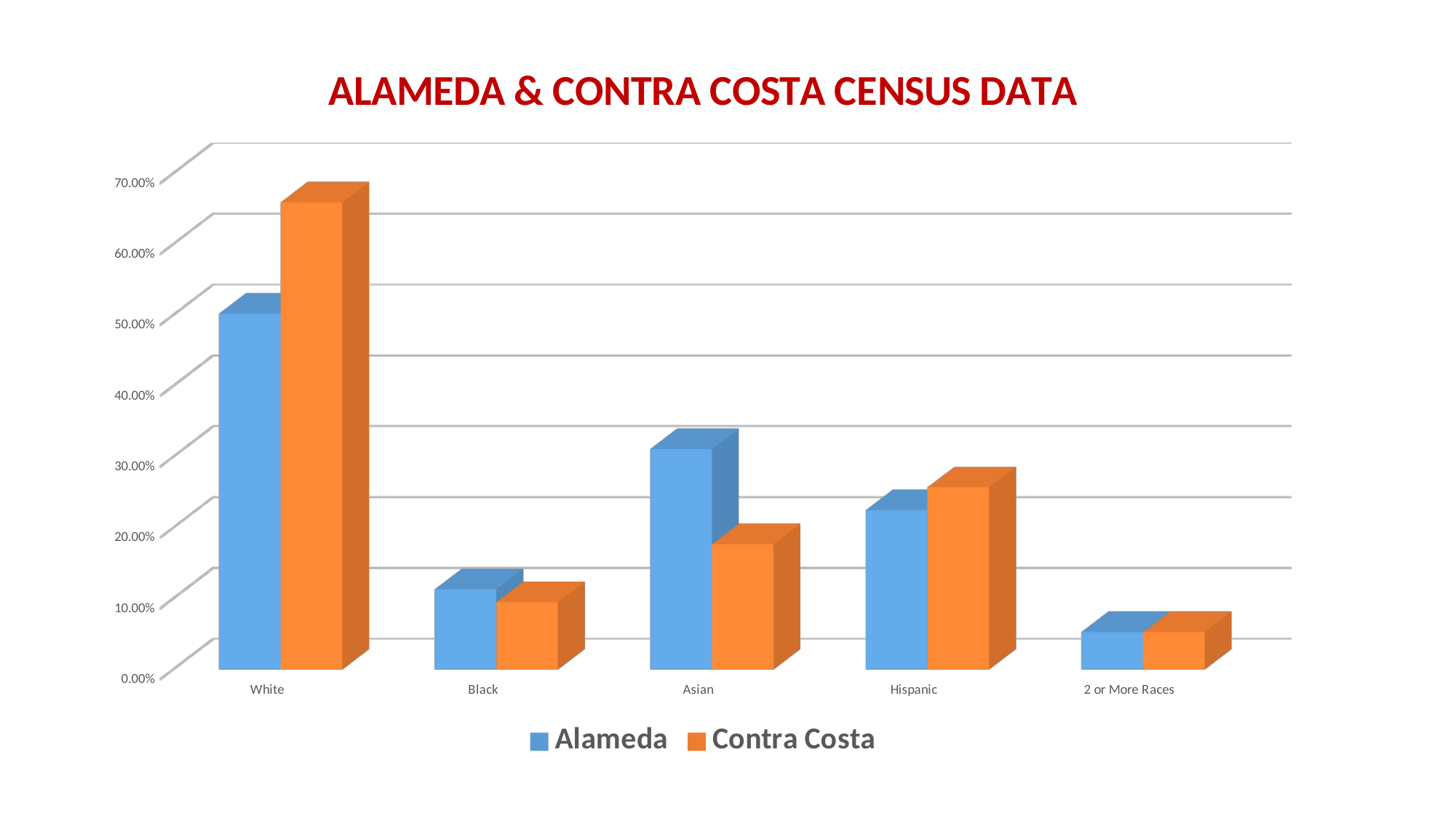
Which category has the highest value for Alameda? White What type of chart is shown on the slide? Bar chart How many categories are shown on the x axis? 5 Which category has the highest value for Contra Costa? White For the White category, which series has the larger value, Alameda or Contra Costa? Contra Costa What is the title of the chart? ALAMEDA & CONTRA COSTA CENSUS DATA How many series does the legend list? 2 Is the Alameda value for Asian greater or less than 20.00%? greater For the Asian category, which series has the larger value, Alameda or Contra Costa? Alameda Is the Alameda value for 2 or More Races greater or less than 10.00%? less Is the Contra Costa value for White greater or less than 60.00%? greater Which category has the lowest value for Alameda? 2 or More Races